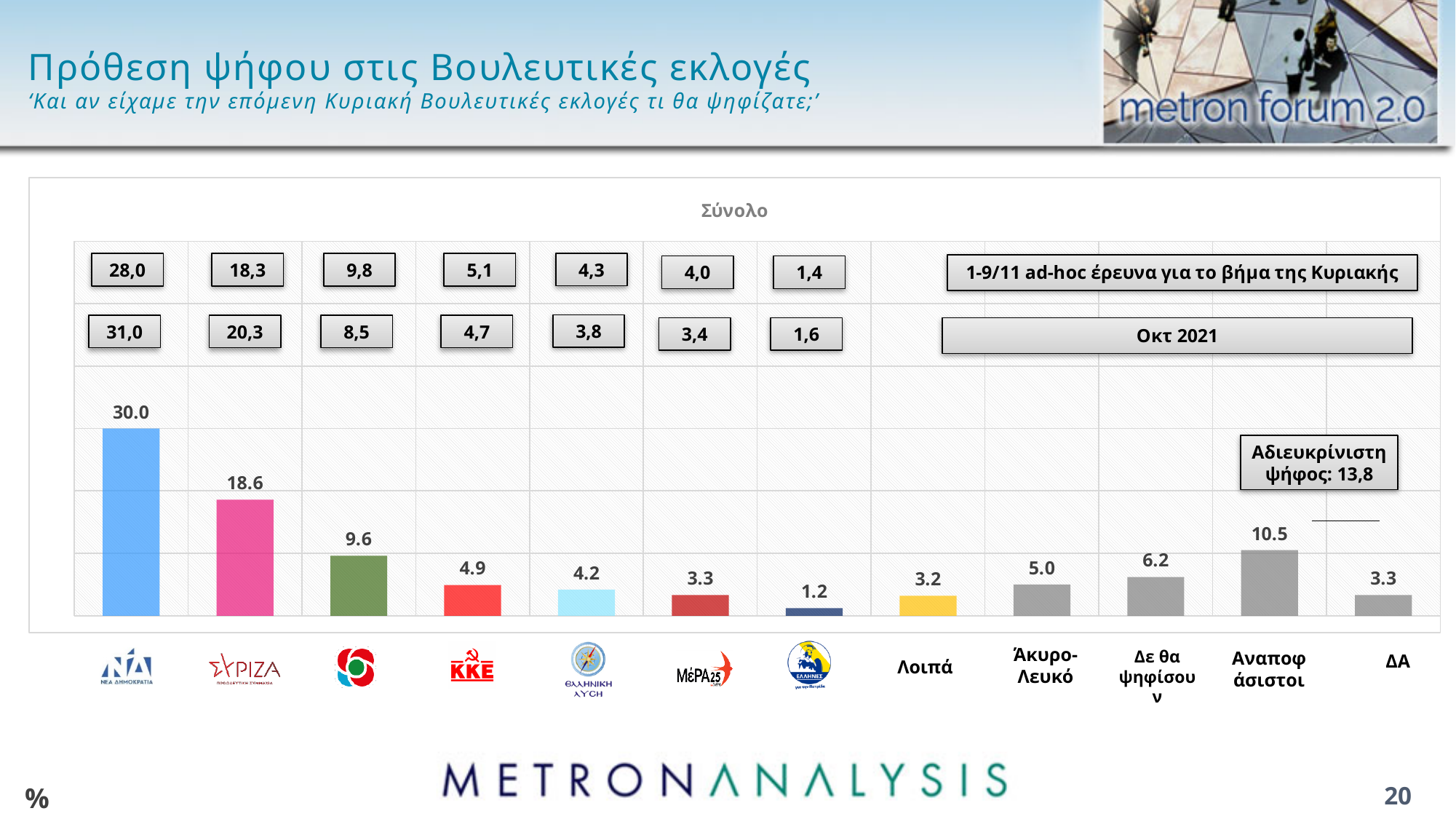
Which is larger, the bar for Δε θα ψηφίσουν or the bar for Άκυρο-Λευκό? Δε θα ψηφίσουν What is the title of the chart? Σύνολο What is the value of the bar for ΚΚΕ? 4.9 What value is given for Αδιευκρίνιστη ψήφος in the box on the chart? 13,8 What is the value of the bar for ΔΑ? 3.3 What is the value of the bar for ΣΥΡΙΖΑ? 18.6 What is the value of the bar for ΝΕΑ ΔΗΜΟΚΡΑΤΙΑ? 30.0 What is the difference between the bars for ΝΕΑ ΔΗΜΟΚΡΑΤΙΑ and ΣΥΡΙΖΑ? 11.4 What kind of chart is shown on the slide? bar chart How many bars are plotted in the chart? 12 What is the value of the bar for Αναποφάσιστοι? 10.5 Which category has the highest bar? ΝΕΑ ΔΗΜΟΚΡΑΤΙΑ